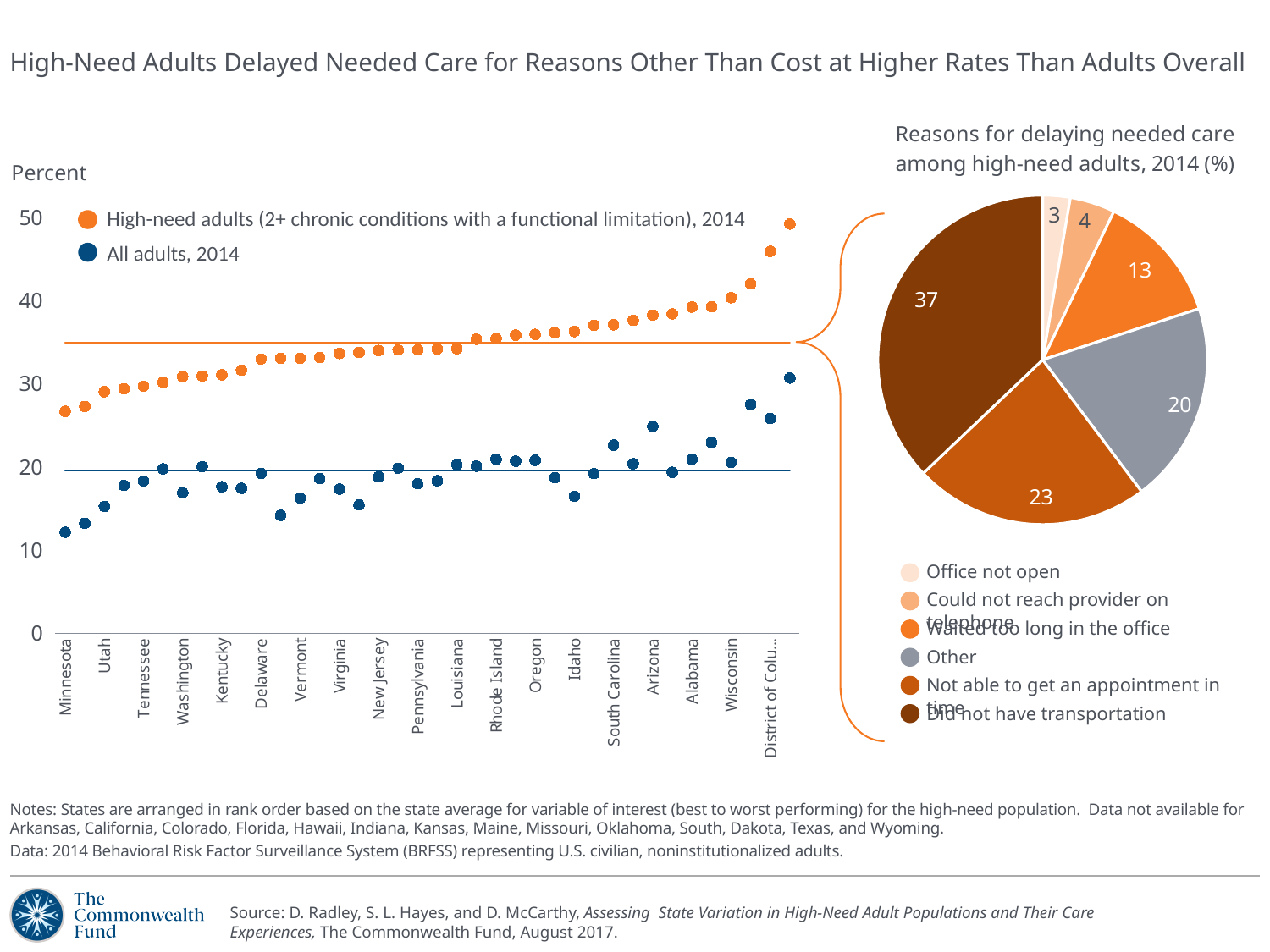
In the pie chart, which reason for delaying care has the largest slice? Did not have transportation In the pie chart, what is the difference between the 'Did not have transportation' slice and the 'Not able to get an appointment in time' slice? 14 In the dot chart on the left, is the value for high-need adults in the District of Columbia greater or less than 40? greater How many reasons does the legend of the pie chart list? 6 In the pie chart, what value is shown for 'Not able to get an appointment in time'? 23 In the pie chart, which reason for delaying care has the smallest slice? Office not open In the dot chart on the left, how many series does the legend list? 2 In the pie chart, which is larger: 'Other' or 'Waited too long in the office'? Other In the dot chart on the left, is the value for high-need adults in Minnesota greater or less than 30? less In the pie chart, what value is shown for 'Waited too long in the office'? 13 In the dot chart on the left, do the values for high-need adults rise or fall from left to right across the states? rise In the pie chart, what percentage of high-need adults cited 'Did not have transportation' as a reason for delaying care? 37